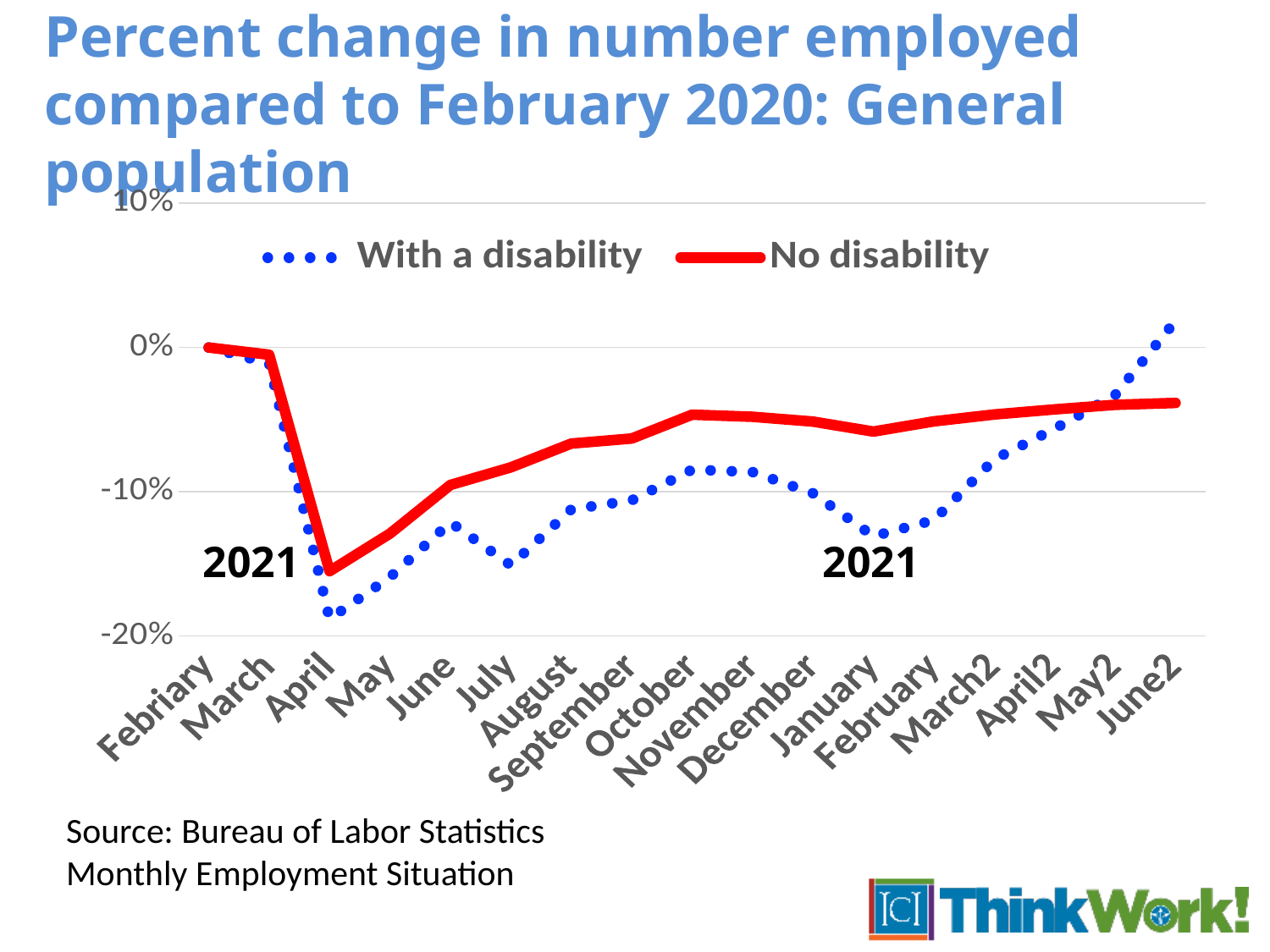
Is the value for 'With a disability' in June2 greater or less than 0%? greater In April, which series has the lower value, 'With a disability' or 'No disability'? With a disability In which month does the 'With a disability' line reach its lowest value? April Does the 'With a disability' line rise or fall from January to June2? rise Which two series are listed in the legend? With a disability; No disability In which month does the 'With a disability' line reach its highest value? June2 How many months (points) are plotted along the x axis? 17 In which month does the 'No disability' line reach its lowest value? April What kind of chart is shown on the slide? line chart Is the value for 'No disability' in October greater or less than -10%? greater How many series does the legend list? 2 Is the value for 'With a disability' in April greater or less than -10%? less